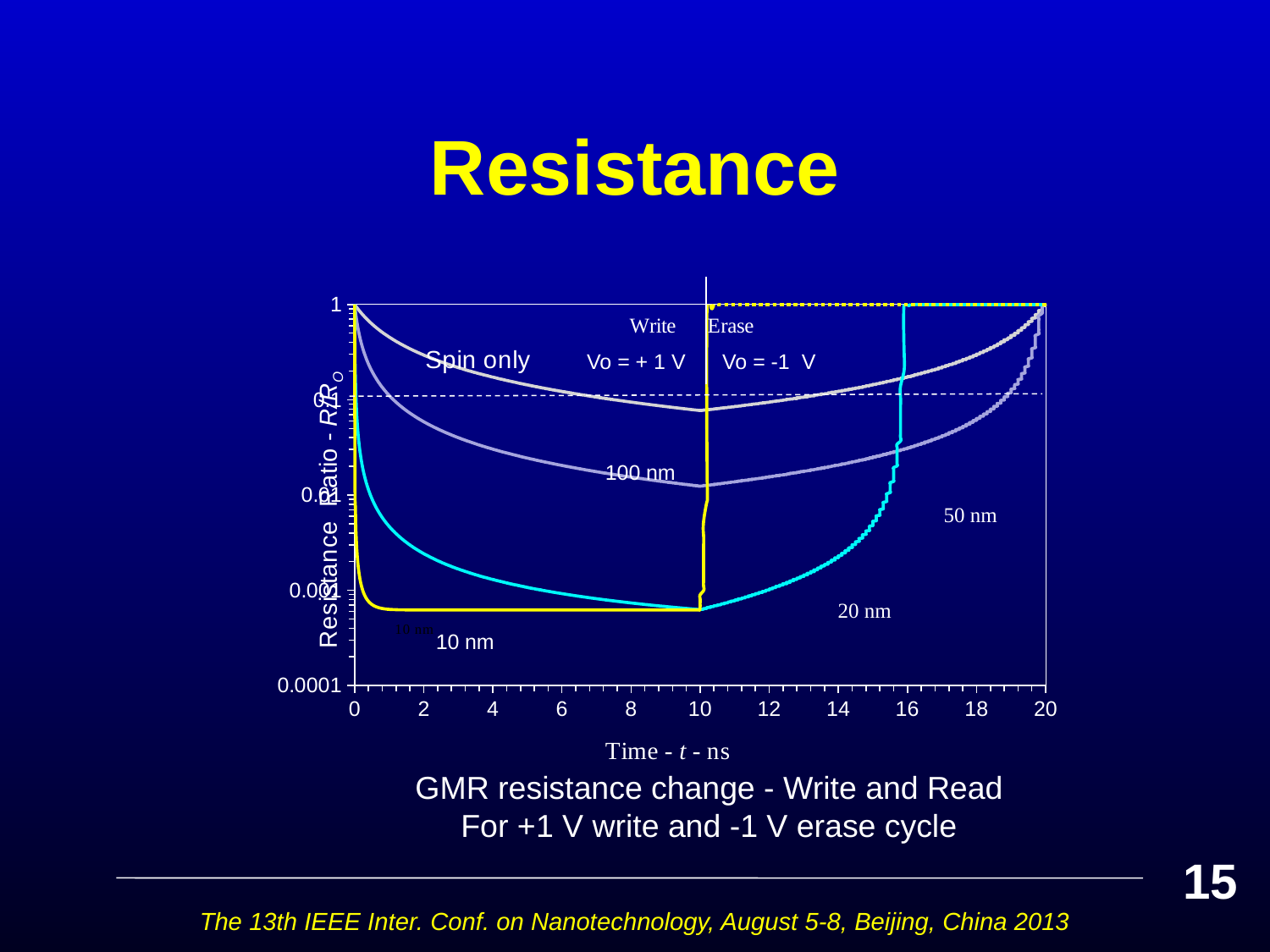
Is the value of the Spin only curve at 10 ns greater or less than 0.1? greater Which labelled curve stays highest on the chart throughout the cycle? Spin only What kind of chart is shown on the slide? line chart Is the value of the 10 nm curve at 5 ns greater or less than 0.01? less Which labelled curve reaches the lowest resistance ratio on the chart? 10 nm Do the curves rise or fall along the x axis during the erase phase (10 to 20 ns)? rise What write voltage Vo is annotated on the chart? + 1 V At 5 ns, which curve has the larger value, Spin only or 20 nm? Spin only How many labelled curves are plotted on the chart? 5 What is the label of the x axis of the chart? Time - t - ns Do the curves rise or fall along the x axis during the write phase (0 to 10 ns)? fall What is the maximum value shown on the x axis of the chart? 20